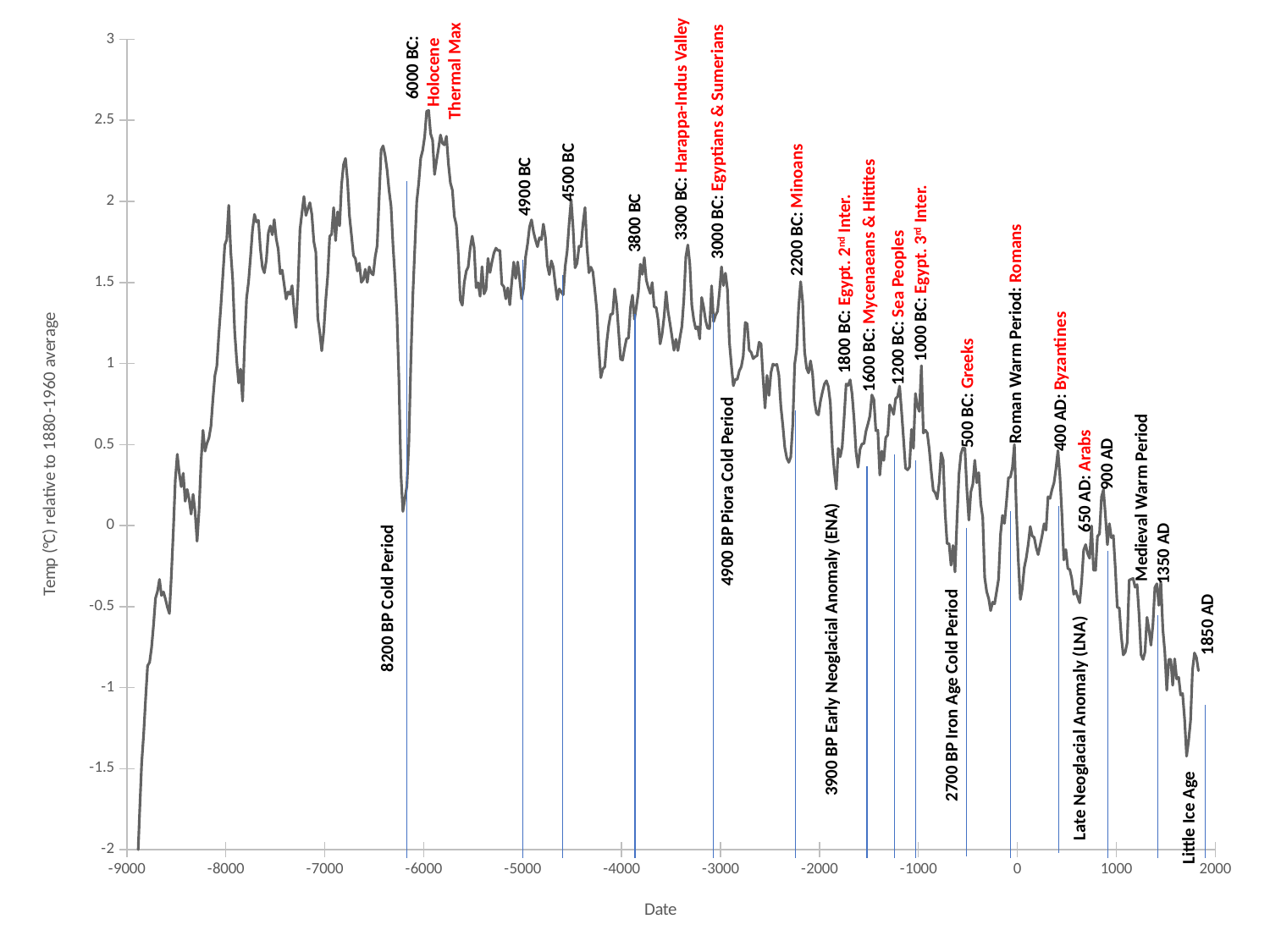
Is the temperature at the bottom of the 8200 BP Cold Period dip greater or less than 0.5? less Is the temperature at the lowest point of the Little Ice Age greater or less than -1? less What is the title of the horizontal axis? Date Which labeled event marks the highest temperature on the chart? 6000 BC: Holocene Thermal Max Which is higher, the temperature at the 6000 BC Holocene Thermal Max or at the Roman Warm Period peak? 6000 BC Holocene Thermal Max What type of chart is shown on the slide? line chart Is the temperature at the 6000 BC Holocene Thermal Max peak greater or less than 2? greater What is the title of the vertical axis? Temp (°C) relative to 1880-1960 average Overall, do temperatures rise or fall from the 6000 BC Holocene Thermal Max to 1850 AD? fall